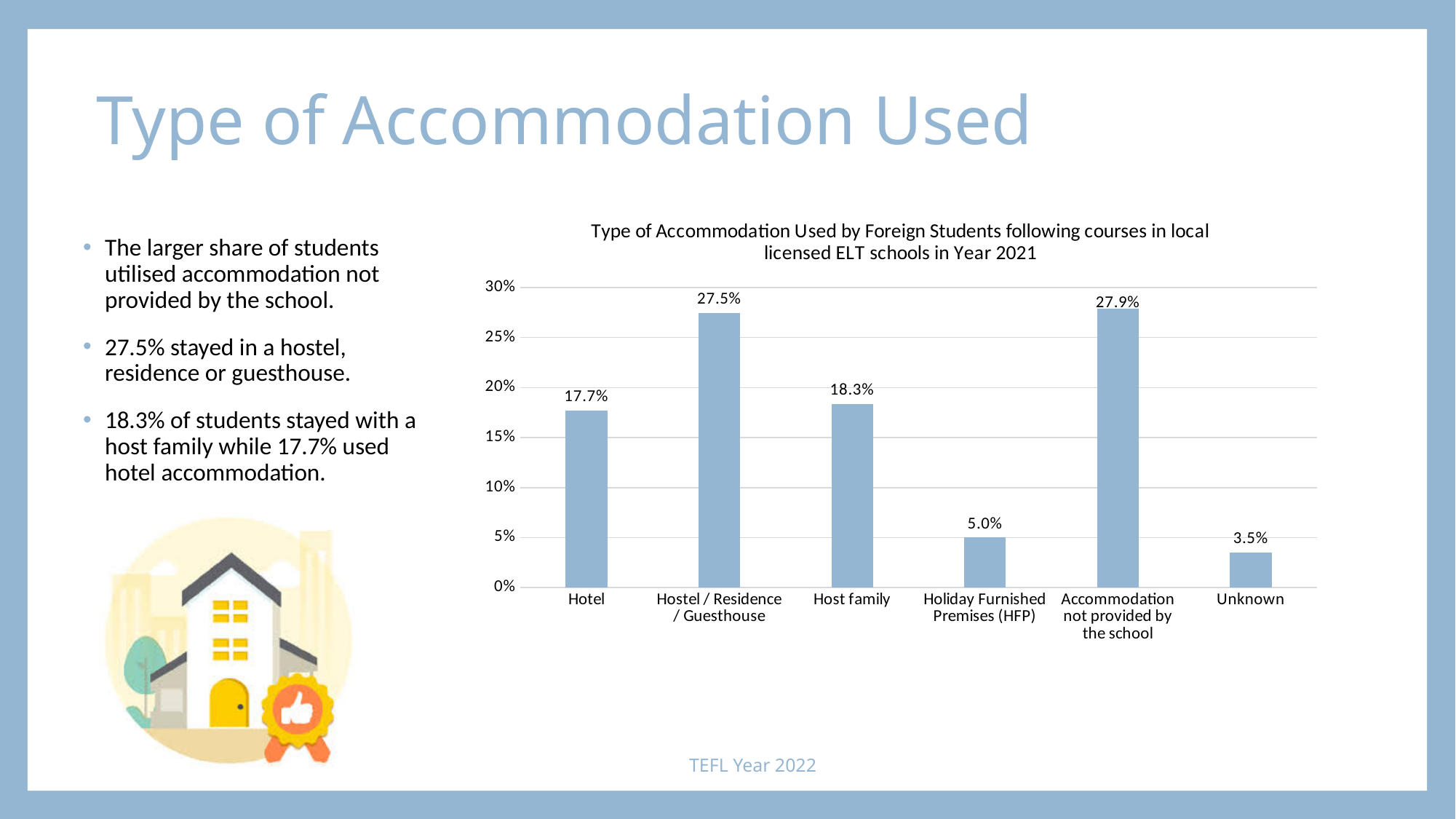
What is the difference between the values for Accommodation not provided by the school and Hostel / Residence / Guesthouse? 0.4% What is the value for Unknown? 3.5% What kind of chart is shown on the slide? Bar chart Which category has the lowest value? Unknown Which category has the highest value? Accommodation not provided by the school Is the value for Hotel greater or less than 20%? less How many categories are shown on the x axis? 6 What is the value for Holiday Furnished Premises (HFP)? 5.0% Which is larger, the value for Host family or the value for Holiday Furnished Premises (HFP)? Host family What is the value for Hotel? 17.7% What is the value for Hostel / Residence / Guesthouse? 27.5% What is the difference between the values for Host family and Hotel? 0.6%